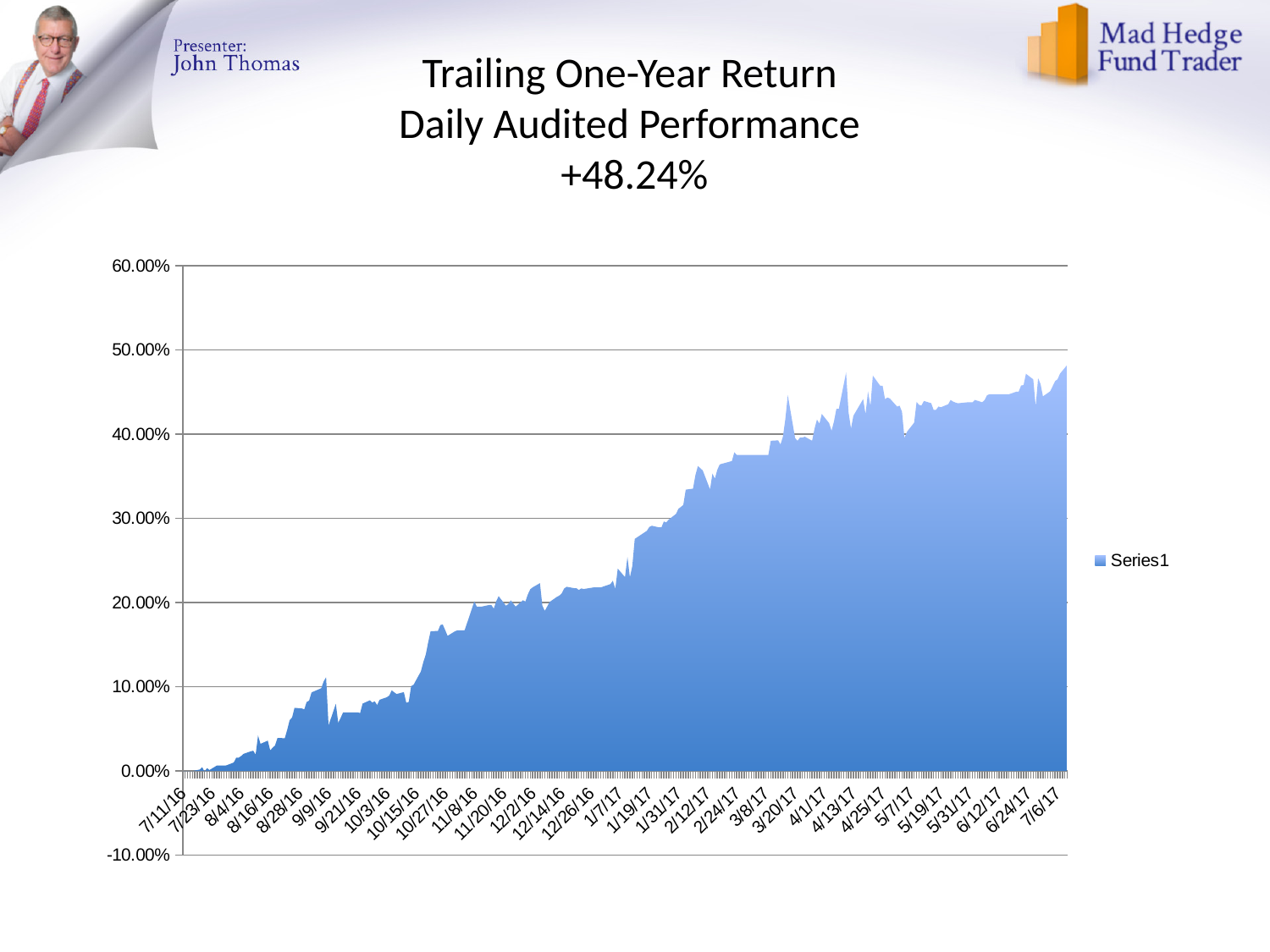
Is the value at 7/6/17 greater or less than 40.00%? greater How many series does the legend list? 1 What is the name of the series shown in the legend? Series1 What kind of chart is shown on the slide? area chart What return figure is printed in the chart title? +48.24% What is the highest value shown on the y axis? 60.00% Is the value at 3/8/17 greater or less than 30.00%? greater Is the value at 8/4/16 greater or less than 10.00%? less Do the values generally rise or fall from 7/11/16 to 7/6/17? rise